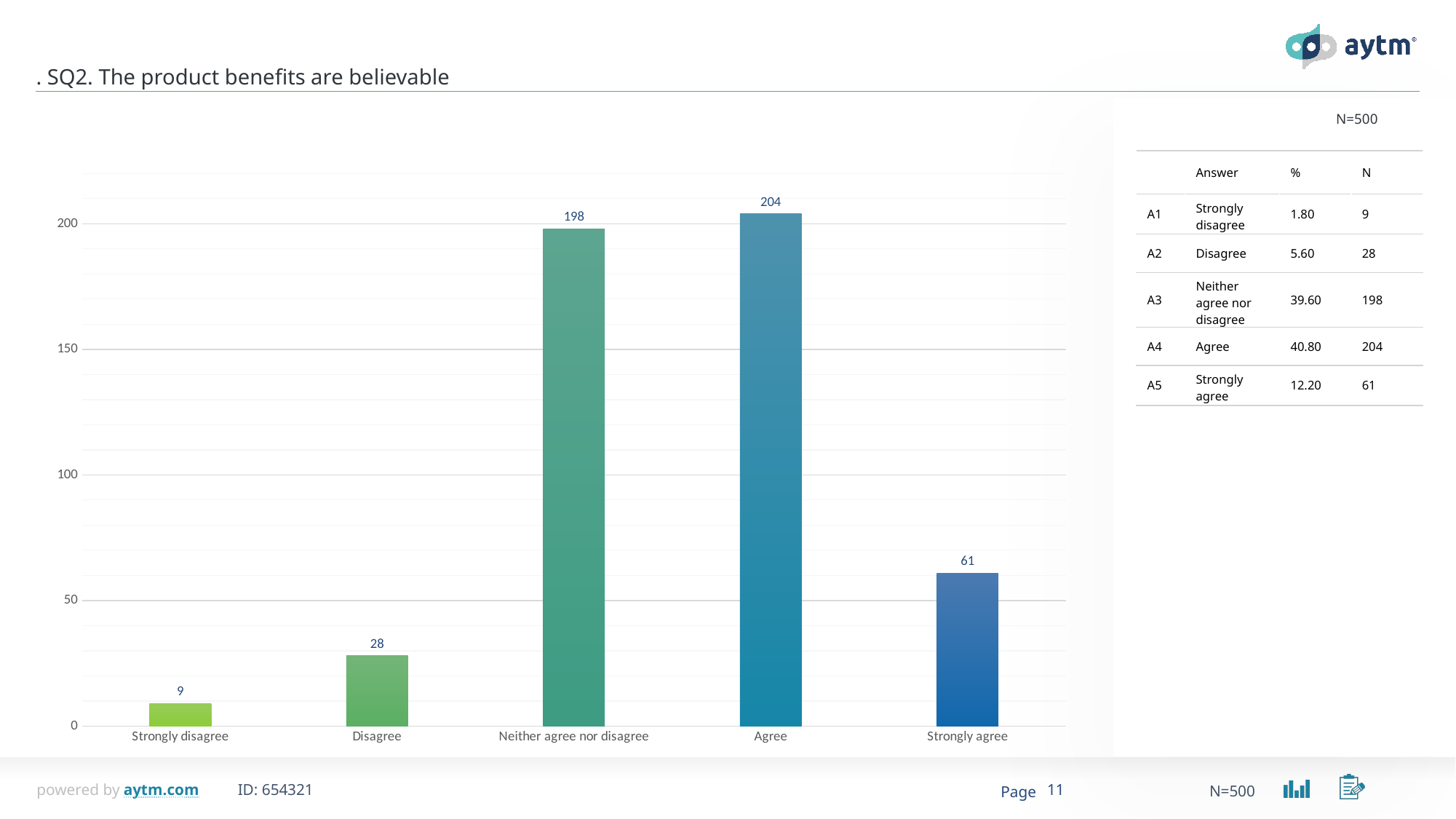
Is the value for Strongly agree greater or less than 50? greater Which category has the highest value? Agree What is the value for Strongly disagree? 9 Which is larger, the value for Strongly agree or the value for Disagree? Strongly agree What is the value for Neither agree nor disagree? 198 What is the difference between the values for Strongly agree and Disagree? 33 Which category has the lowest value? Strongly disagree What is the difference between the values for Agree and Neither agree nor disagree? 6 What kind of chart is shown on the slide? bar chart What is the value for Agree? 204 How many categories are shown on the x axis? 5 What is the title of the slide? SQ2. The product benefits are believable